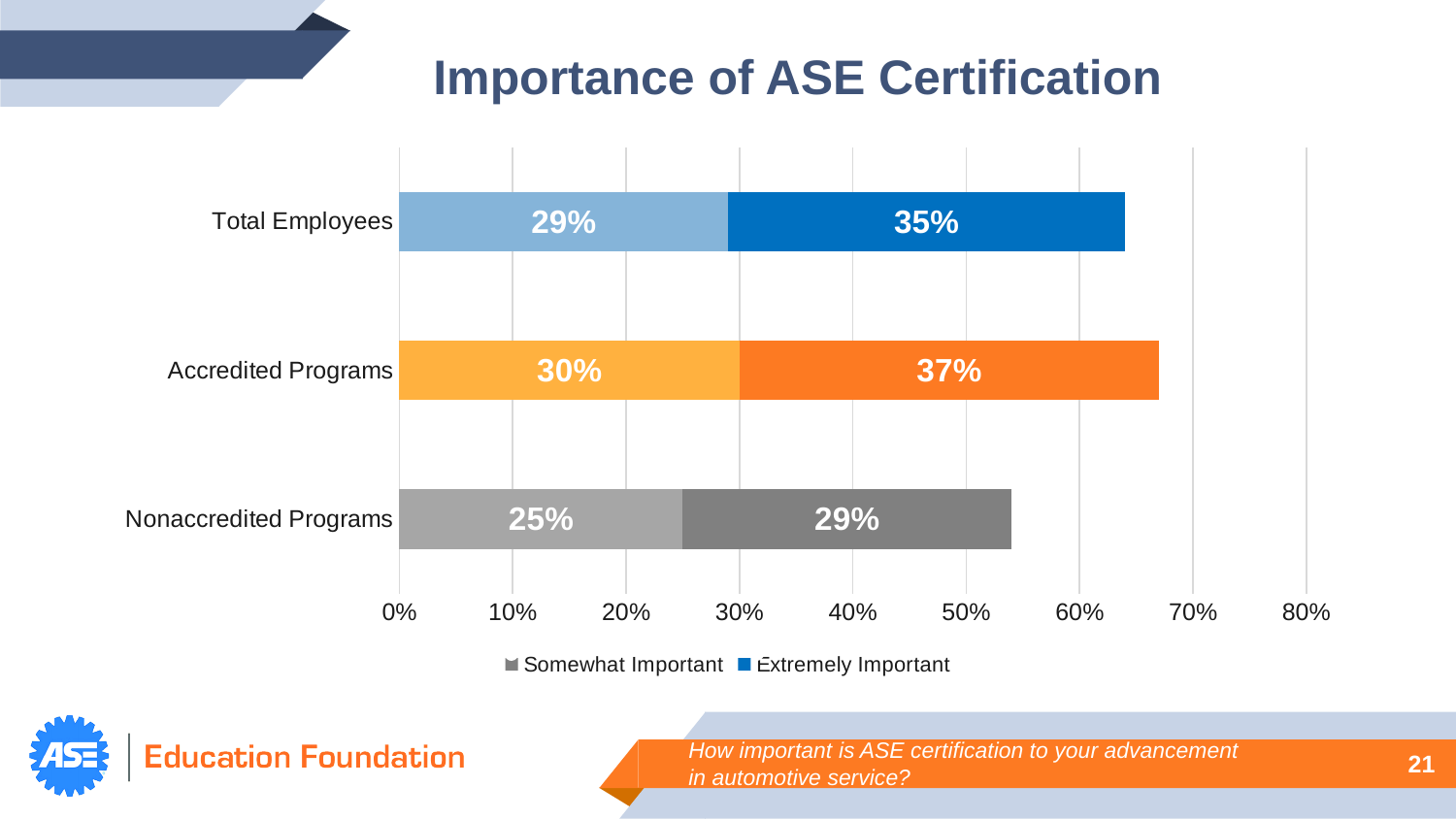
What is the combined total of the stacked bar for Nonaccredited Programs? 54% What is the combined total of the stacked bar for Accredited Programs? 67% What is the 'Extremely Important' value for Accredited Programs? 37% Which category has the highest 'Extremely Important' value? Accredited Programs How many categories are shown on the chart? 3 What is the 'Somewhat Important' value for Nonaccredited Programs? 25% How many series does the legend list? 2 What is the 'Extremely Important' value for Total Employees? 35% Which is larger: the 'Somewhat Important' value for Total Employees or for Accredited Programs? Accredited Programs What type of chart is shown on the slide? Stacked bar chart Which category has the lowest 'Somewhat Important' value? Nonaccredited Programs What is the difference between the 'Extremely Important' values for Accredited Programs and Nonaccredited Programs? 8%